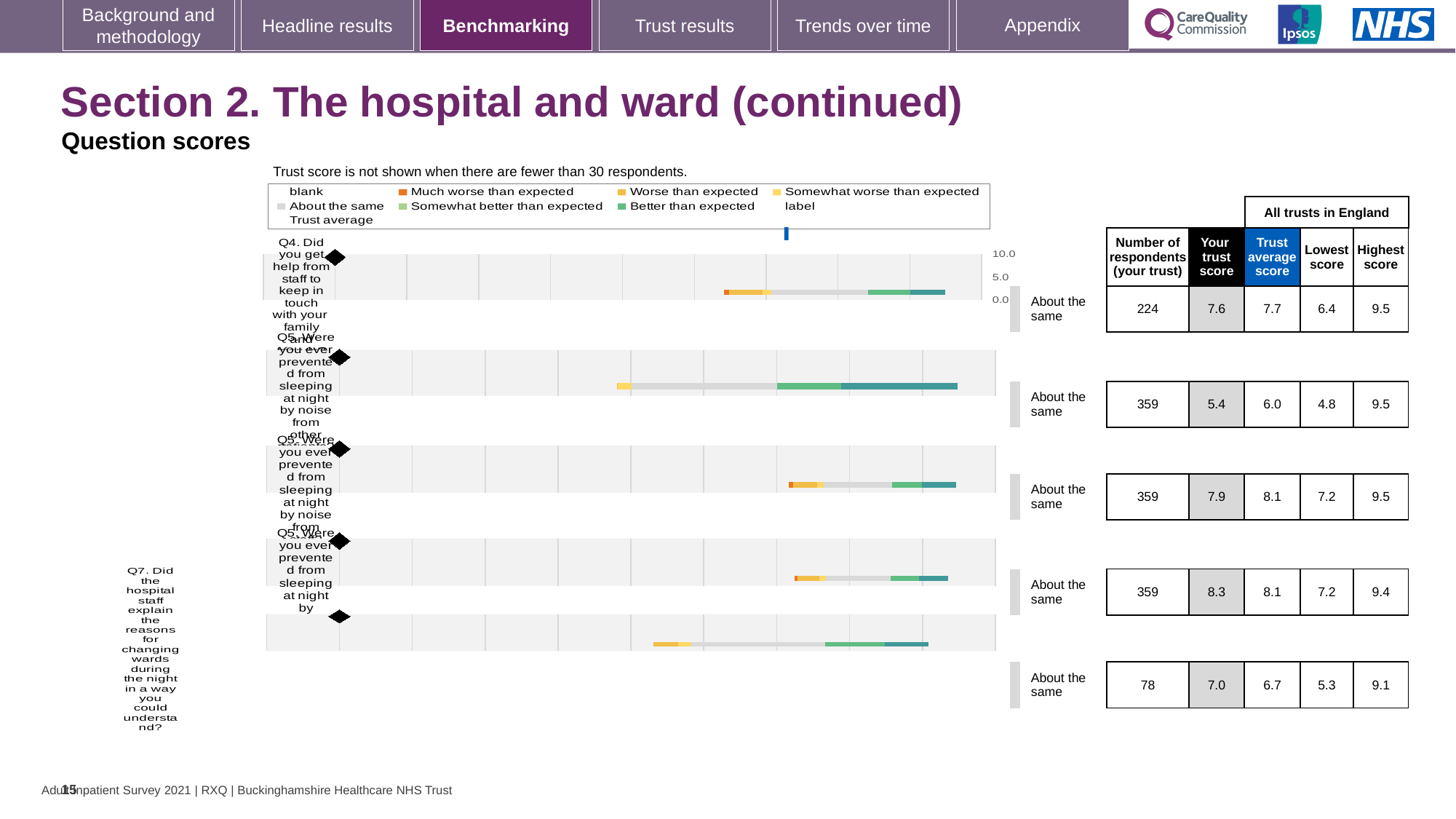
In the chart legend, which colour represents 'Better than expected'? teal What kind of chart is used to show the question scores on this slide? bar chart In the chart legend, which colour represents 'Much worse than expected'? orange For Q7 (staff explaining reasons for changing wards during the night), how many respondents did the trust have? 78 For Q7 (staff explaining reasons for changing wards during the night), what is the lowest score across all trusts in England? 5.3 For Q4 (help from staff to keep in touch with family and friends), which is larger: the trust's own score or the trust average score? the trust average score For Q4 (help from staff to keep in touch with family and friends), what is the trust score shown in the 'Your trust score' column? 7.6 For Q7 (staff explaining reasons for changing wards during the night), what is the trust score shown in the 'Your trust score' column? 7.0 For Q4 (help from staff to keep in touch with family and friends), what is the difference between the highest score (9.5) and the lowest score (6.4) across all trusts in England? 3.1 For Q4 (help from staff to keep in touch with family and friends), how many respondents did the trust have? 224 For Q4 (help from staff to keep in touch with family and friends), what is the trust average score for all trusts in England? 7.7 How many question score bars (chart panels) are shown on the slide? 5